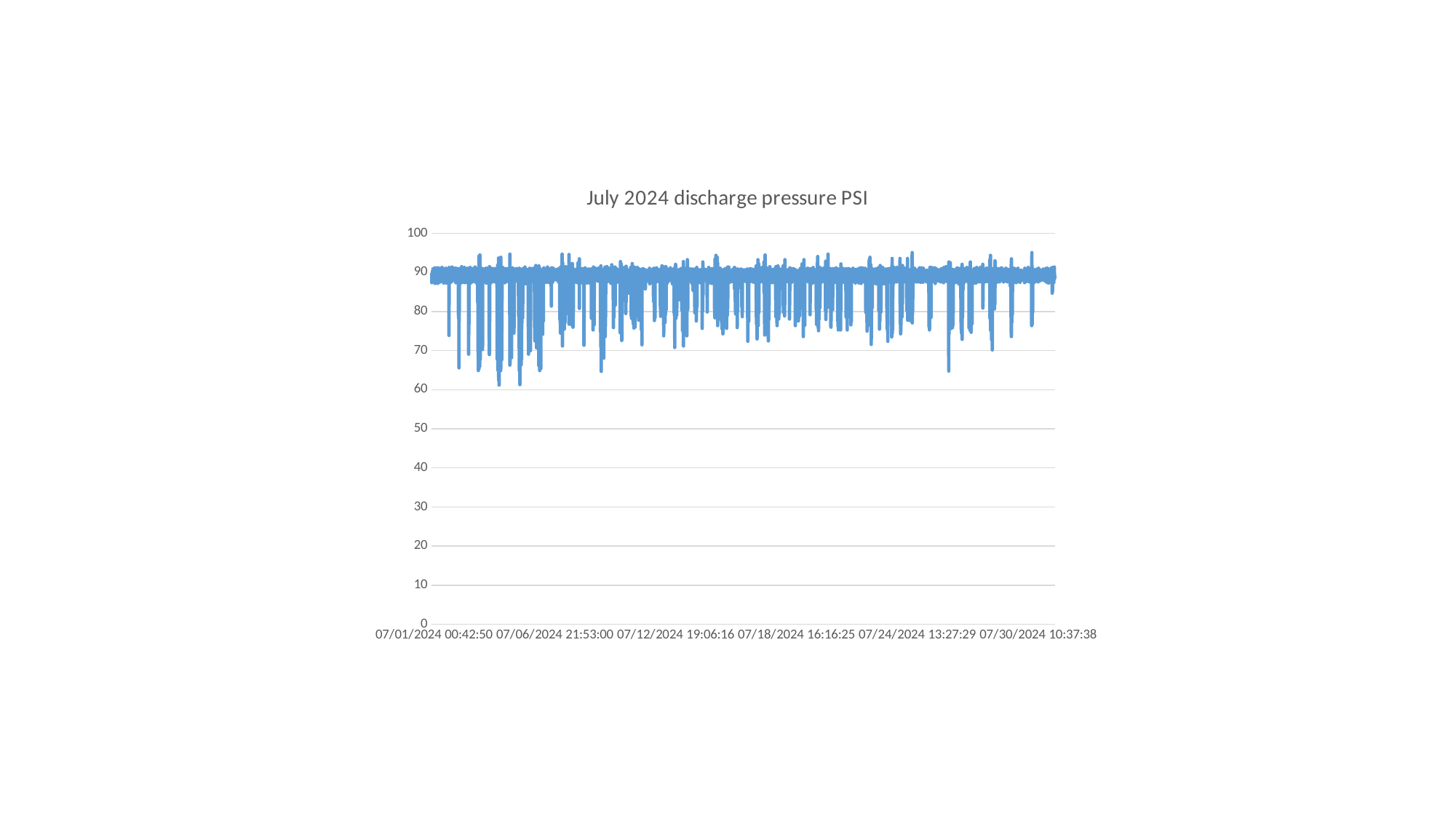
What is the highest value shown on the vertical axis? 100 Is the lowest value reached by the line greater or less than 70? less What is the title of the chart? July 2024 discharge pressure PSI Is the lowest value reached by the line greater or less than 50? greater How many date-time labels are shown on the horizontal axis? 6 Is the highest value reached by the line greater or less than 100? less What type of chart is shown on the slide? line chart